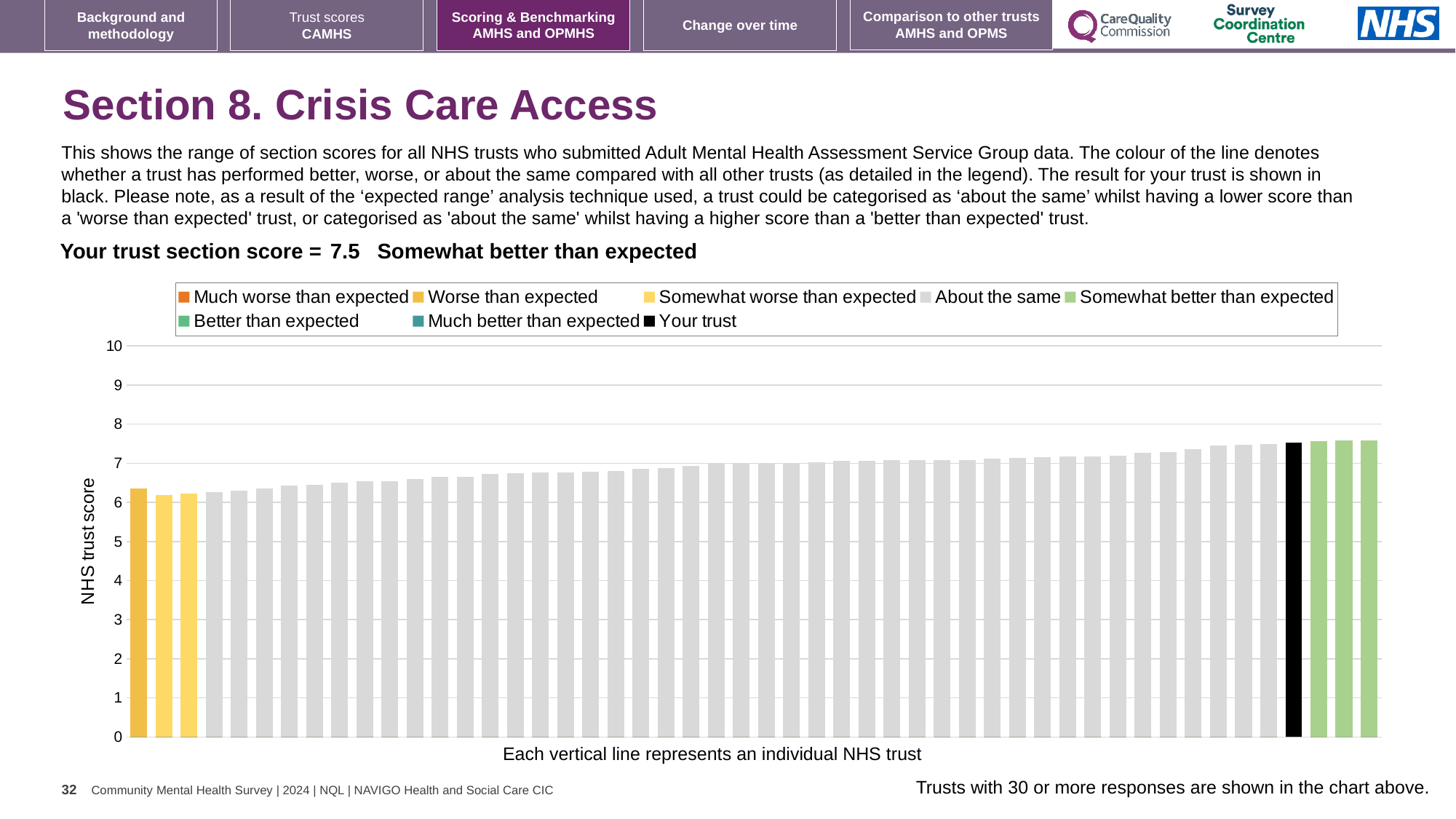
Is the value of the rightmost bar greater or less than 8? less How many bars are coloured green (somewhat better than expected)? 3 What is the label on the vertical axis of the chart? NHS trust score What colour is the bar representing your trust? black Is the value of the leftmost bar greater or less than 5? greater Is the value of the black bar (your trust) greater or less than 7? greater How many entries does the chart legend list? 8 What kind of chart is shown on the slide? bar chart What is the section score for your trust shown on the slide? 7.5 Do the bar values rise or fall from left to right along the x axis? rise Which legend category does your trust's section score fall into? Somewhat better than expected